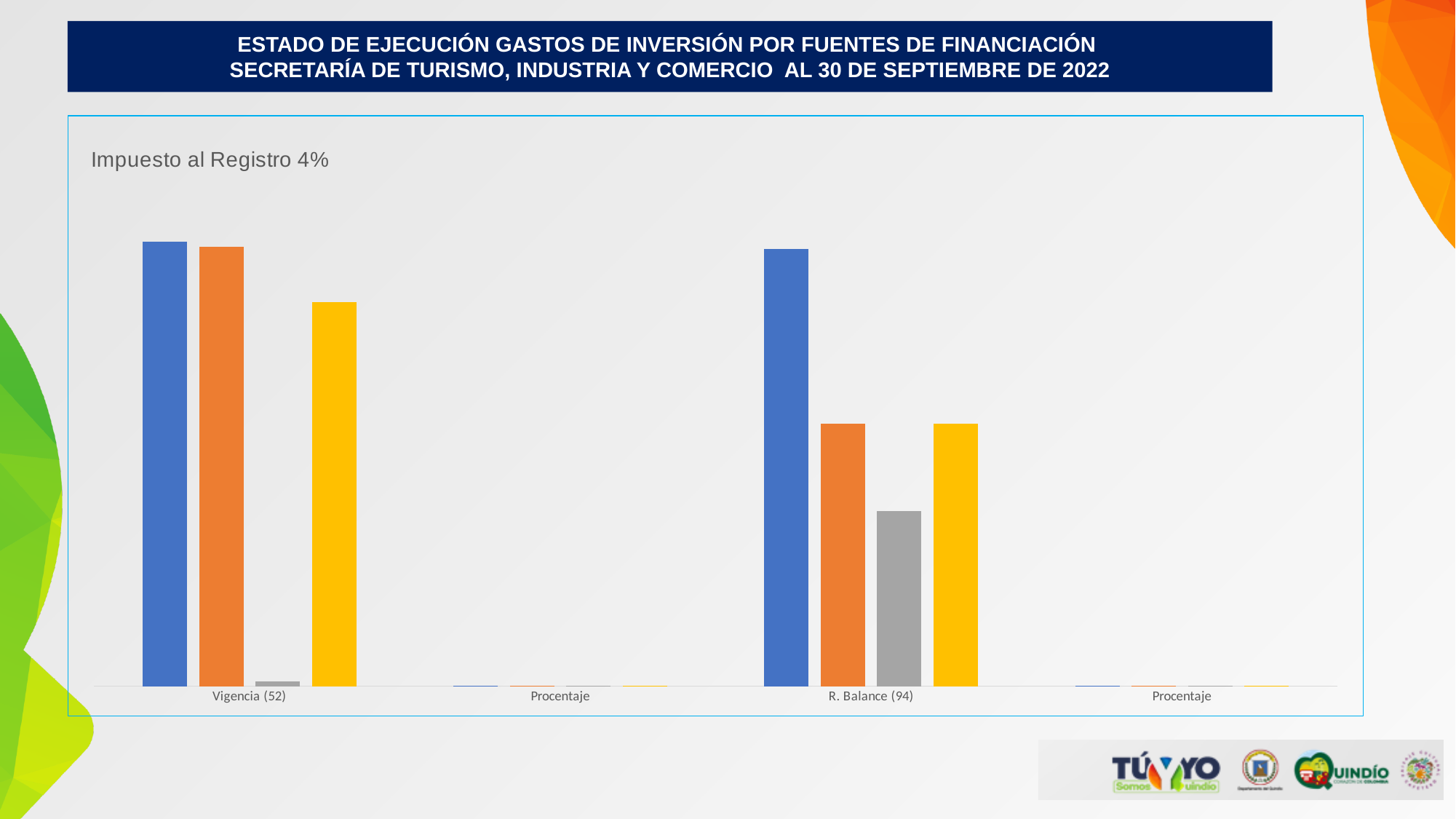
Which is taller, the orange bar for Vigencia (52) or the orange bar for R. Balance (94)? Vigencia (52) What is the title of the chart? Impuesto al Registro 4% How many bars are plotted for the category Vigencia (52)? 4 In the category Vigencia (52), which is taller, the blue bar or the gray bar? The blue bar What kind of chart is shown on the slide? Bar chart In the category R. Balance (94), which is taller, the blue bar or the orange bar? The blue bar In the category Vigencia (52), which bar is the tallest? The blue bar What colours are the four bars in each category of the chart? Blue, orange, gray and yellow In the category R. Balance (94), which bar is the shortest? The gray bar How many categories are shown along the x axis of the chart? 4